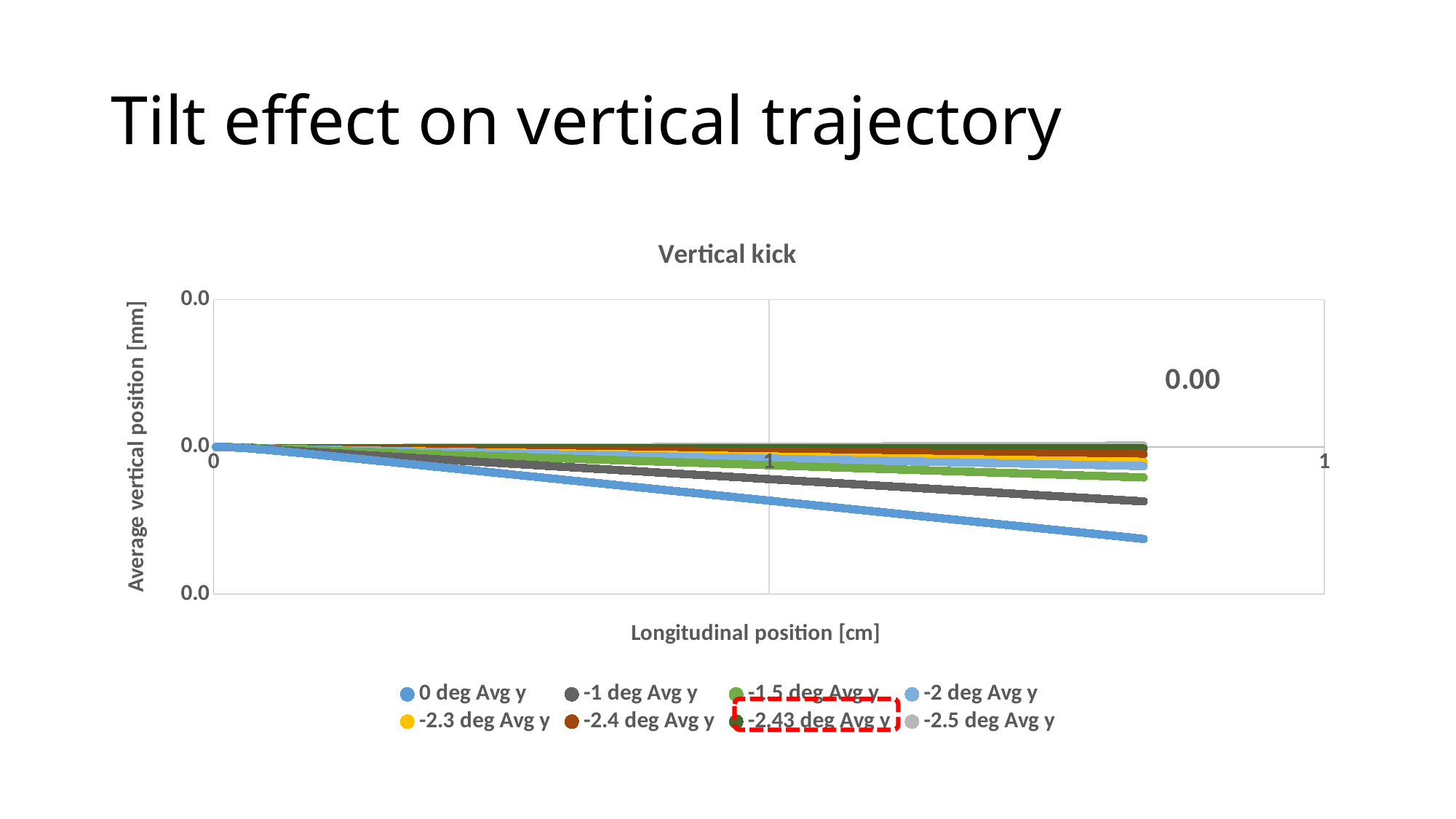
At the right end of the chart, which series is lower: 0 deg Avg y or -1 deg Avg y? 0 deg Avg y How many series does the legend list? 8 What is the label of the x axis? Longitudinal position [cm] Which series ends at the lowest vertical position at the right end of the chart? 0 deg Avg y At the right end of the chart, which series is higher: -1 deg Avg y or -1.5 deg Avg y? -1.5 deg Avg y What kind of chart is shown on the slide? line chart What is the title of the chart? Vertical kick Do the -1 deg Avg y values rise or fall along the x axis? fall Does the 0 deg Avg y series rise or fall as longitudinal position increases? fall Which series has the steepest downward slope? 0 deg Avg y